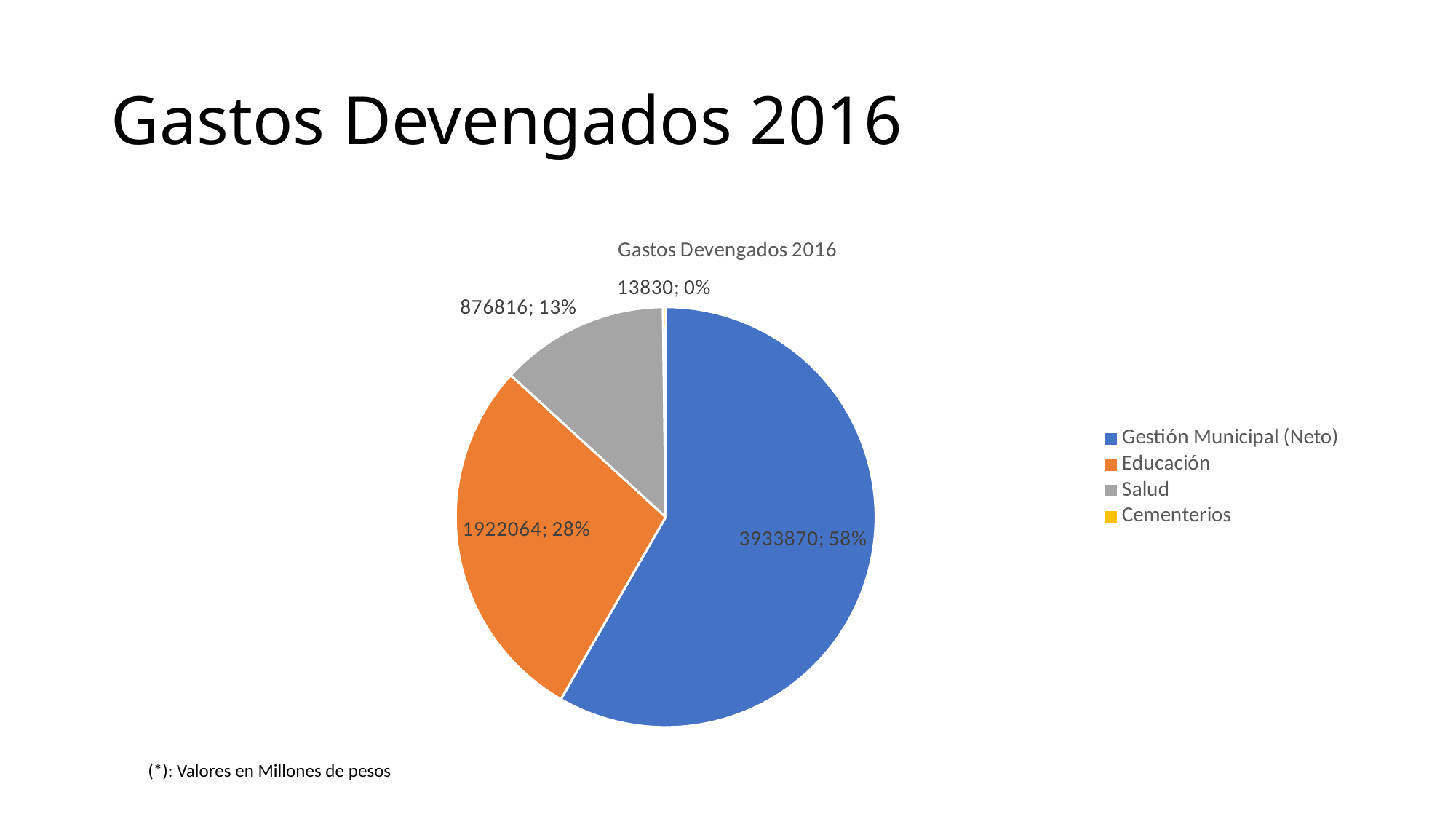
What is the value for Salud? 876816 What type of chart is shown on the slide? pie chart What is the difference between the values for Gestión Municipal (Neto) and Educación? 2011806 Which category has the largest slice? Gestión Municipal (Neto) What is the value for Gestión Municipal (Neto)? 3933870 What is the value for Cementerios? 13830 How many categories does the legend list? 4 What is the value for Educación? 1922064 What share of the pie does Salud represent? 13% Which category has the smallest slice? Cementerios What is the title of the chart? Gastos Devengados 2016 What share of the pie does Educación represent? 28%